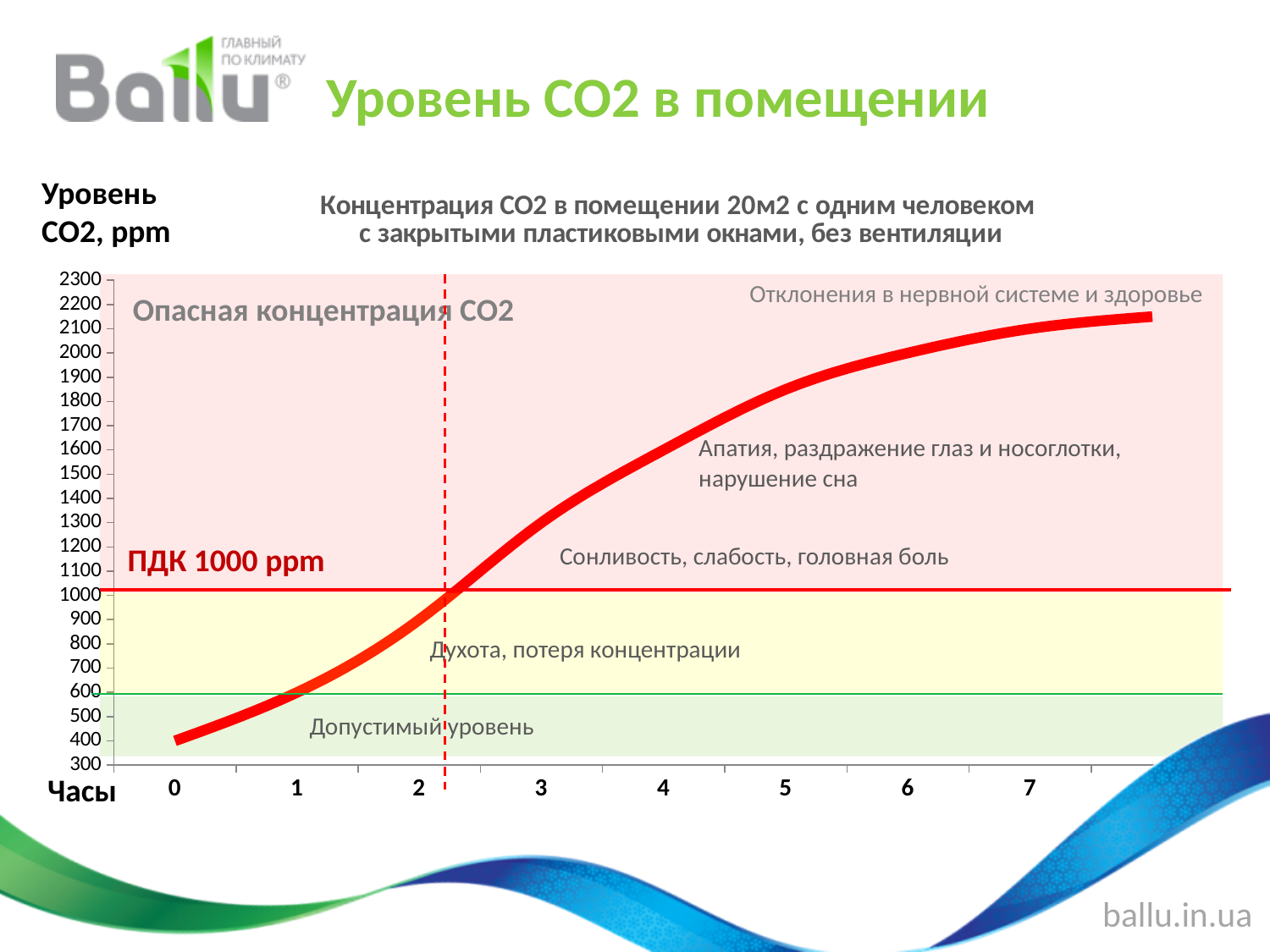
At which labelled hour is the CO2 level lowest? 0 Is the CO2 level at hour 7 greater or less than 2000 ppm? greater Is the CO2 level at hour 5 greater or less than 1700 ppm? greater How many labelled hour ticks are on the horizontal axis? 8 Which is higher, the CO2 level at hour 1 or at hour 7? hour 7 What kind of chart is shown on the slide? line chart Is the CO2 level at hour 2 greater or less than 1000 ppm? less What is the ПДК (maximum permissible concentration) value marked on the chart? 1000 ppm What is the highest value shown on the vertical axis? 2300 Does the CO2 level rise or fall as the hours increase? rise